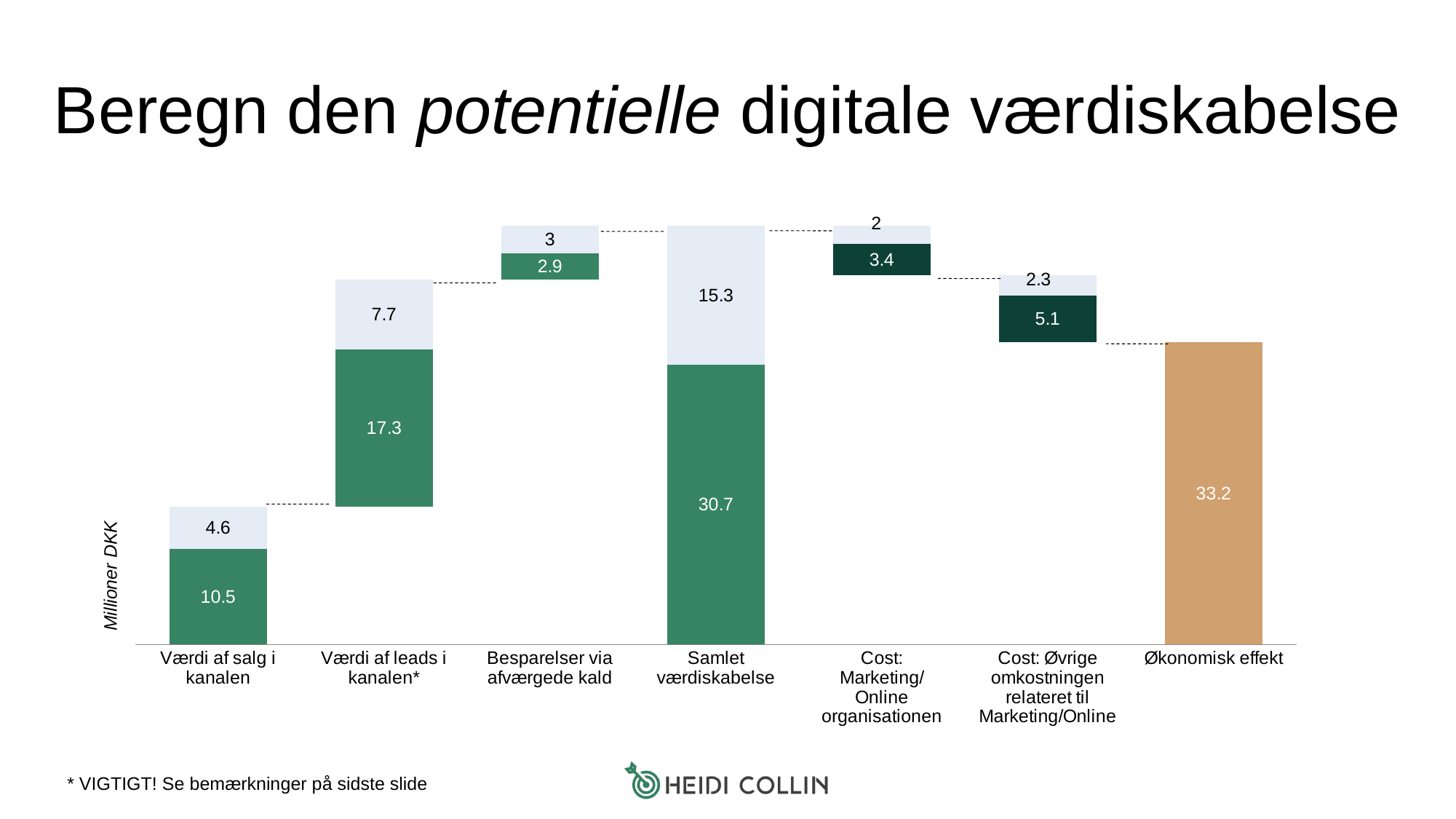
What value is shown for 'Økonomisk effekt'? 33.2 Which category has the smallest dark green value? Besparelser via afværgede kald What is the total of the two stacked segments for 'Værdi af salg i kanalen'? 15.1 What is the difference between the dark green values for 'Værdi af leads i kanalen*' and 'Værdi af salg i kanalen'? 6.8 What unit is given on the vertical axis label? Millioner DKK What is the dark value for 'Cost: Øvrige omkostningen relateret til Marketing/Online'? 5.1 What is the light-coloured value shown above the green bar for 'Værdi af leads i kanalen*'? 7.7 Which category has the largest single labelled value? Økonomisk effekt How many categories are shown on the x axis? 7 What is the dark green value for 'Værdi af salg i kanalen'? 10.5 What is the dark green value for 'Samlet værdiskabelse'? 30.7 Which is larger: the dark value for 'Cost: Marketing/Online organisationen' or the dark value for 'Cost: Øvrige omkostningen relateret til Marketing/Online'? Cost: Øvrige omkostningen relateret til Marketing/Online